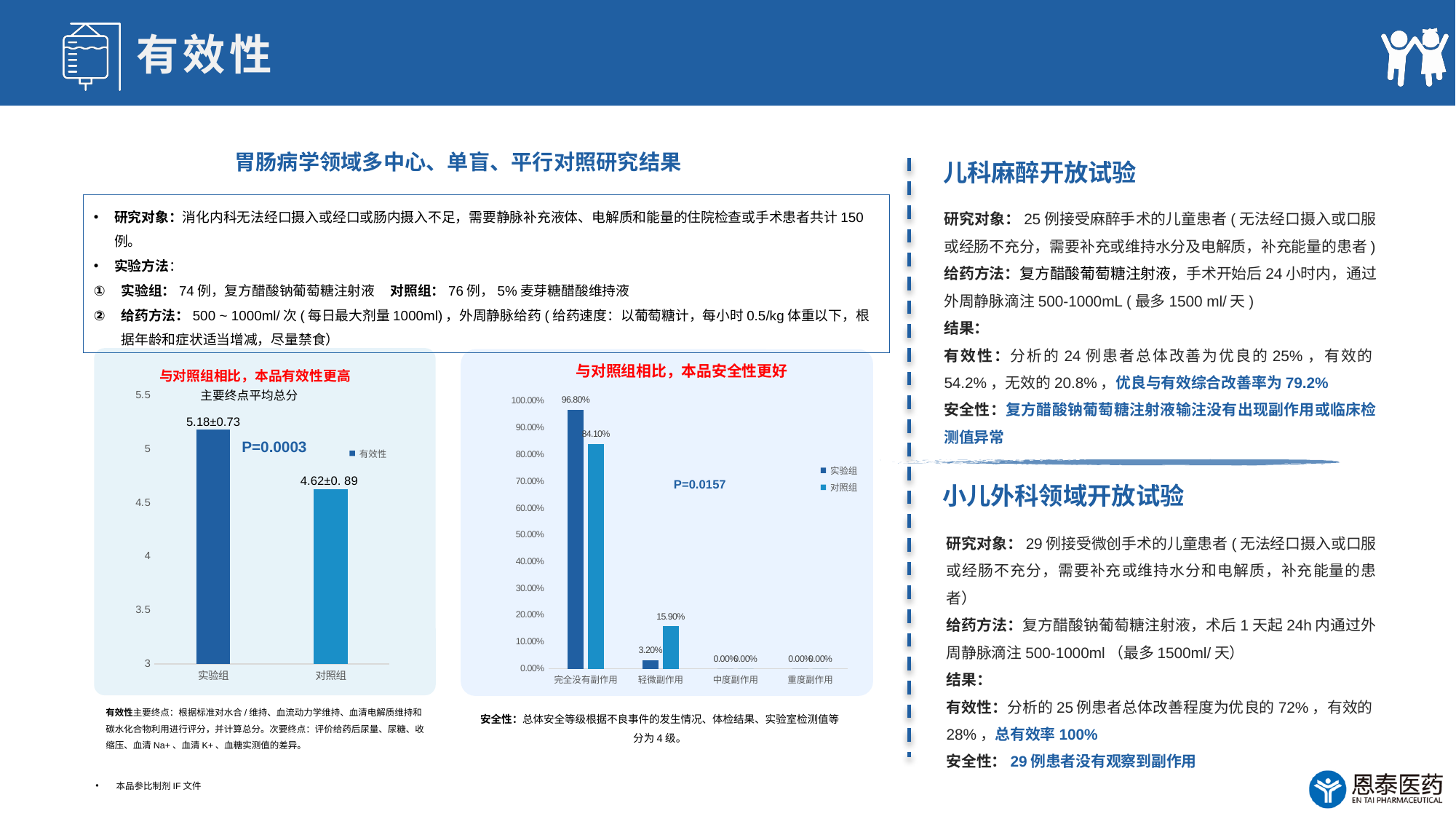
In the right chart (safety), how many categories are shown on the x axis? 4 In the right chart (safety), what is the value for 实验组 in the 完全没有副作用 category? 96.80% In the right chart (safety), how many series does the legend list? 2 In the left chart (主要终点平均总分), what is the value shown for 实验组? 5.18±0.73 In the right chart (safety), what is the value for 实验组 in the 轻微副作用 category? 3.20% In the right chart (safety), which category has the highest value for 对照组? 完全没有副作用 What type of chart is the left chart (主要终点平均总分)? Bar chart In the right chart (safety), what is the value for 对照组 in the 轻微副作用 category? 15.90% In the left chart (主要终点平均总分), which group has the higher mean score? 实验组 In the left chart (主要终点平均总分), what is the value shown for 对照组? 4.62±0.89 In the right chart (safety), what is the difference between 实验组 and 对照组 in the 完全没有副作用 category? 12.70% In the left chart (主要终点平均总分), how many categories are plotted? 2